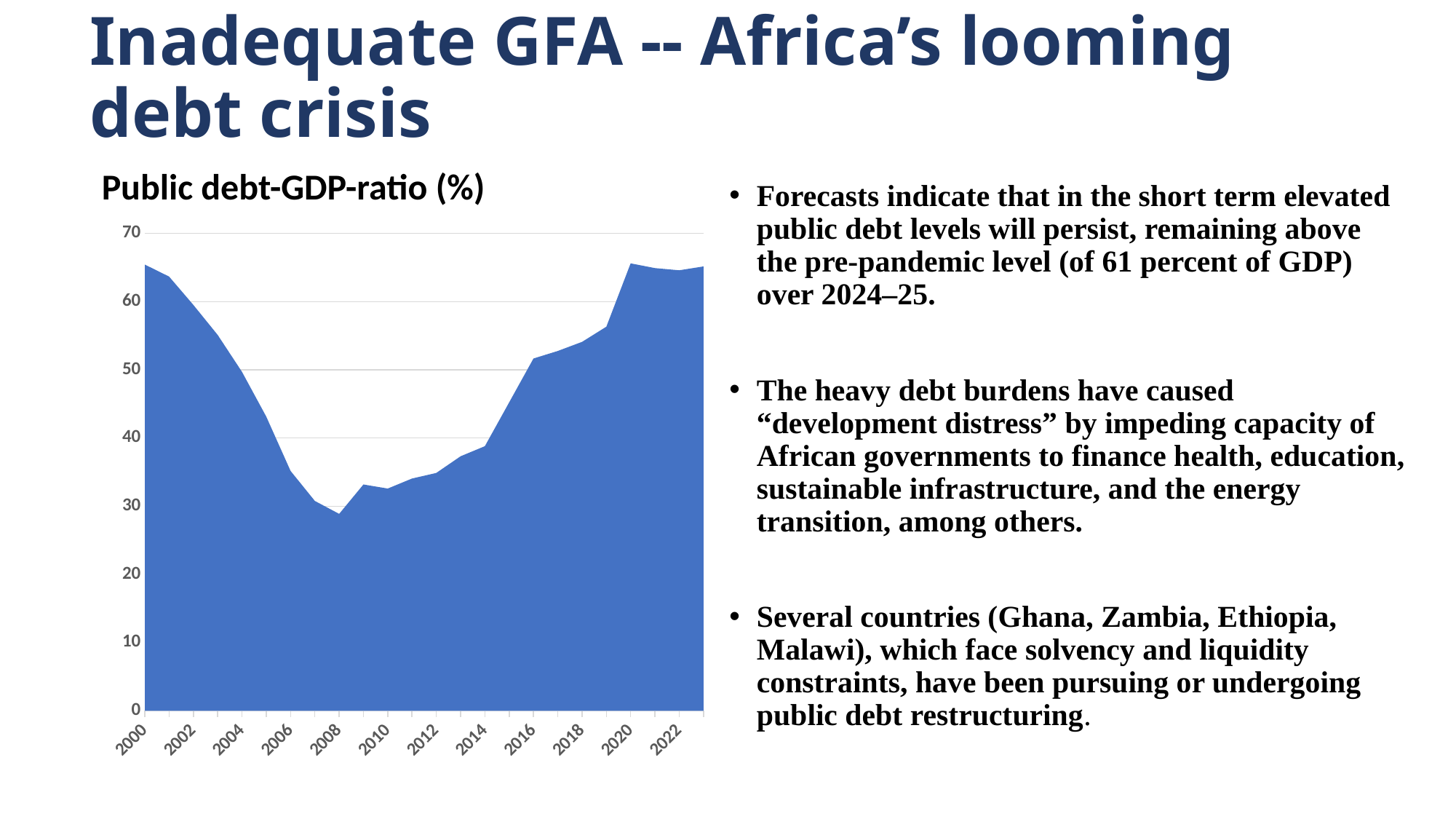
Is the value for 2000 greater or less than 60? greater Is the value for 2012 greater or less than 40? less What kind of chart is shown on the slide? area chart In which year shown on the x axis is the public debt-GDP ratio lowest? 2008 Is the value for 2016 greater or less than 50? greater Which year has the higher public debt-GDP ratio, 2000 or 2008? 2000 How many year labels are shown on the x axis? 12 Does the public debt-GDP ratio rise or fall between 2008 and 2020? rise Does the public debt-GDP ratio rise or fall between 2000 and 2008? fall What is the title of the chart? Public debt-GDP-ratio (%)